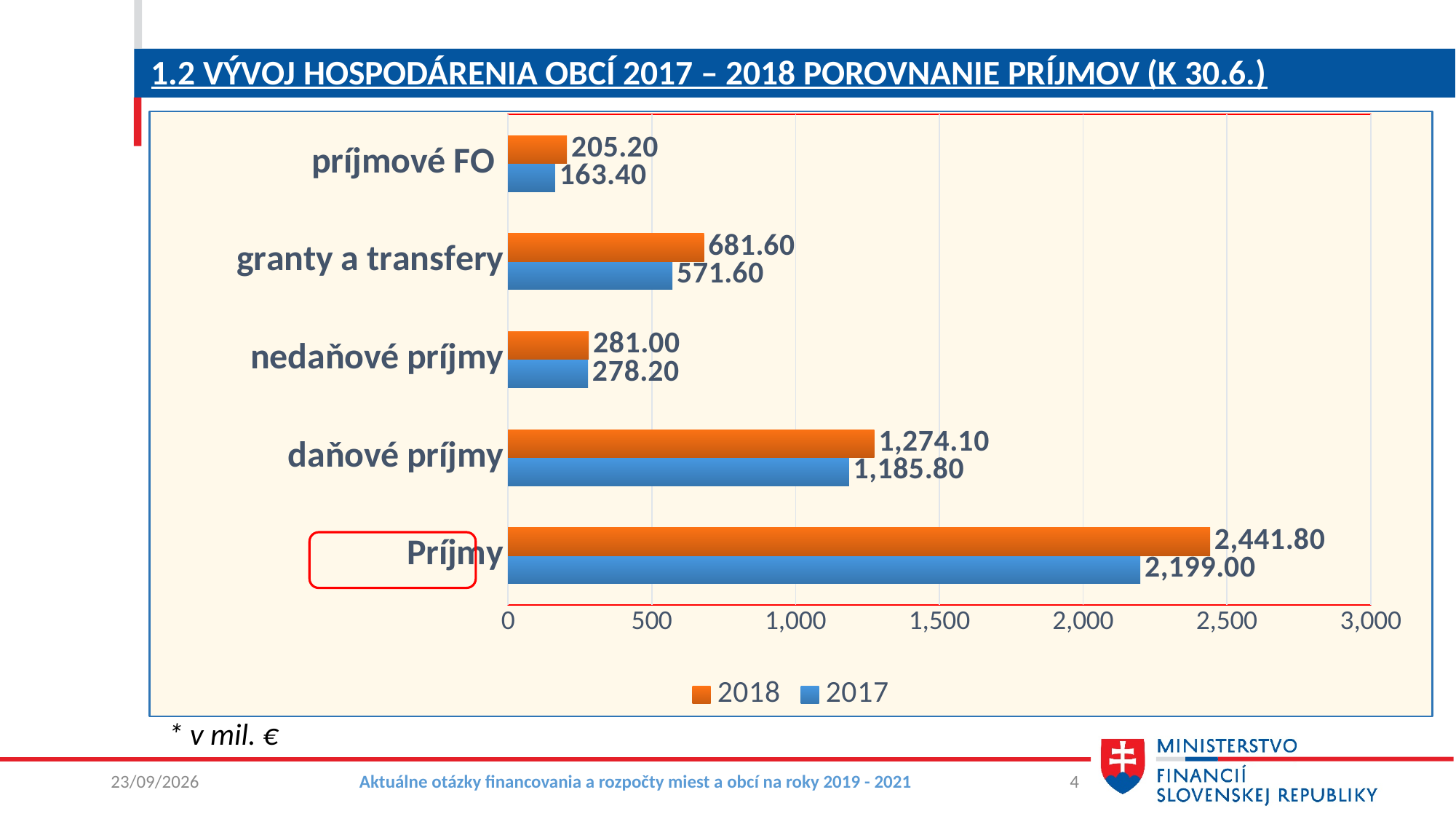
How many categories are shown on the chart? 5 What is the 2018 value for daňové príjmy? 1,274.10 What is the 2017 value for príjmové FO? 163.40 Which category has the highest 2018 value? Príjmy What is the difference between the 2018 and 2017 values for nedaňové príjmy? 2.80 What kind of chart is shown on the slide? bar chart What is the 2017 value for granty a transfery? 571.60 Which is larger for granty a transfery, the 2018 value or the 2017 value? 2018 How many series does the legend list? 2 What is the 2018 value for Príjmy? 2,441.80 Which category has the lowest 2017 value? príjmové FO What is the difference between the 2018 and 2017 values for Príjmy? 242.80